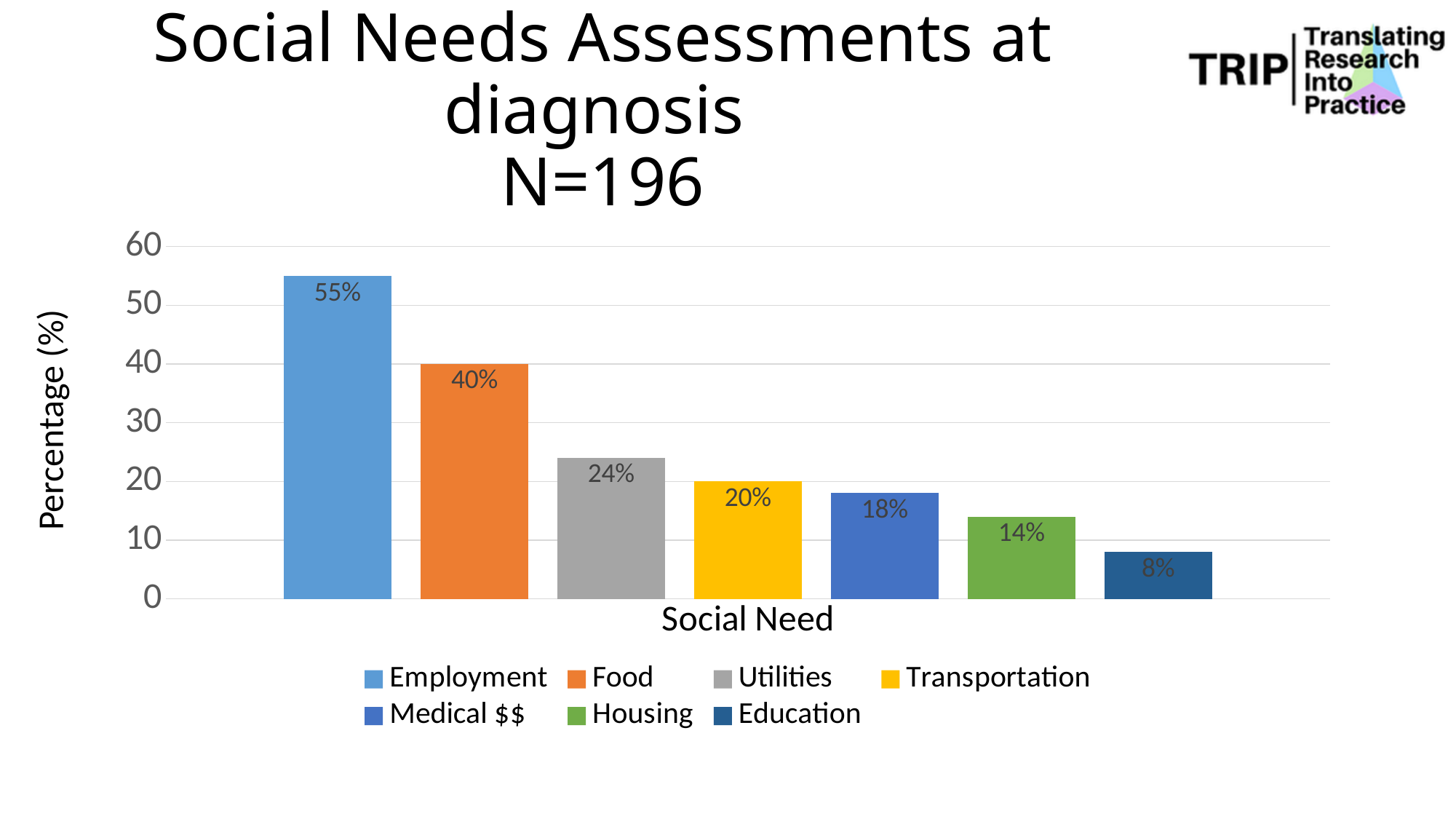
Which social need has the highest percentage? Employment How many social need categories are plotted in the chart? 7 What percentage is shown for Employment? 55% Which social need has the lowest percentage? Education What is the difference in percentage points between Utilities and Housing? 10 What is the difference in percentage points between Employment and Food? 15 What percentage is shown for Medical $$? 18% Which is larger, the value for Transportation or the value for Medical $$? Transportation What percentage is shown for Education? 8% What is the label of the vertical axis? Percentage (%) What kind of chart is shown on the slide? Bar chart What percentage is shown for Food? 40%